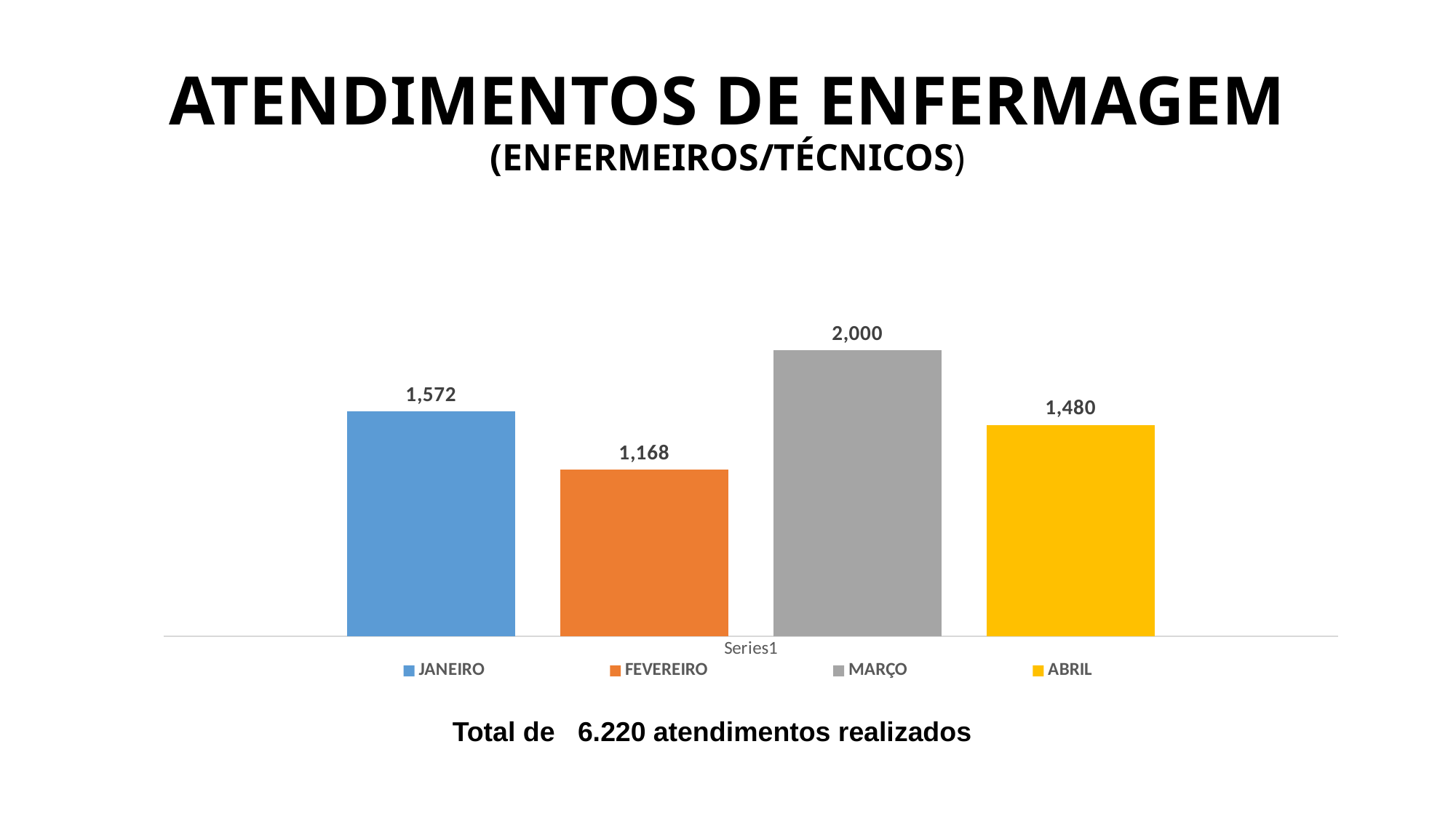
What is the value for FEVEREIRO? 1,168 Which month has the lowest value? FEVEREIRO Which is larger, the value for JANEIRO or the value for ABRIL? JANEIRO What is the difference between the values for JANEIRO and ABRIL? 92 What colour is the bar for MARÇO? Grey What is the value for JANEIRO? 1,572 What is the value for ABRIL? 1,480 What kind of chart is shown on the slide? Bar chart What is the difference between the values for MARÇO and FEVEREIRO? 832 What is the value for MARÇO? 2,000 Which month has the highest value? MARÇO How many bars are shown in the chart? 4